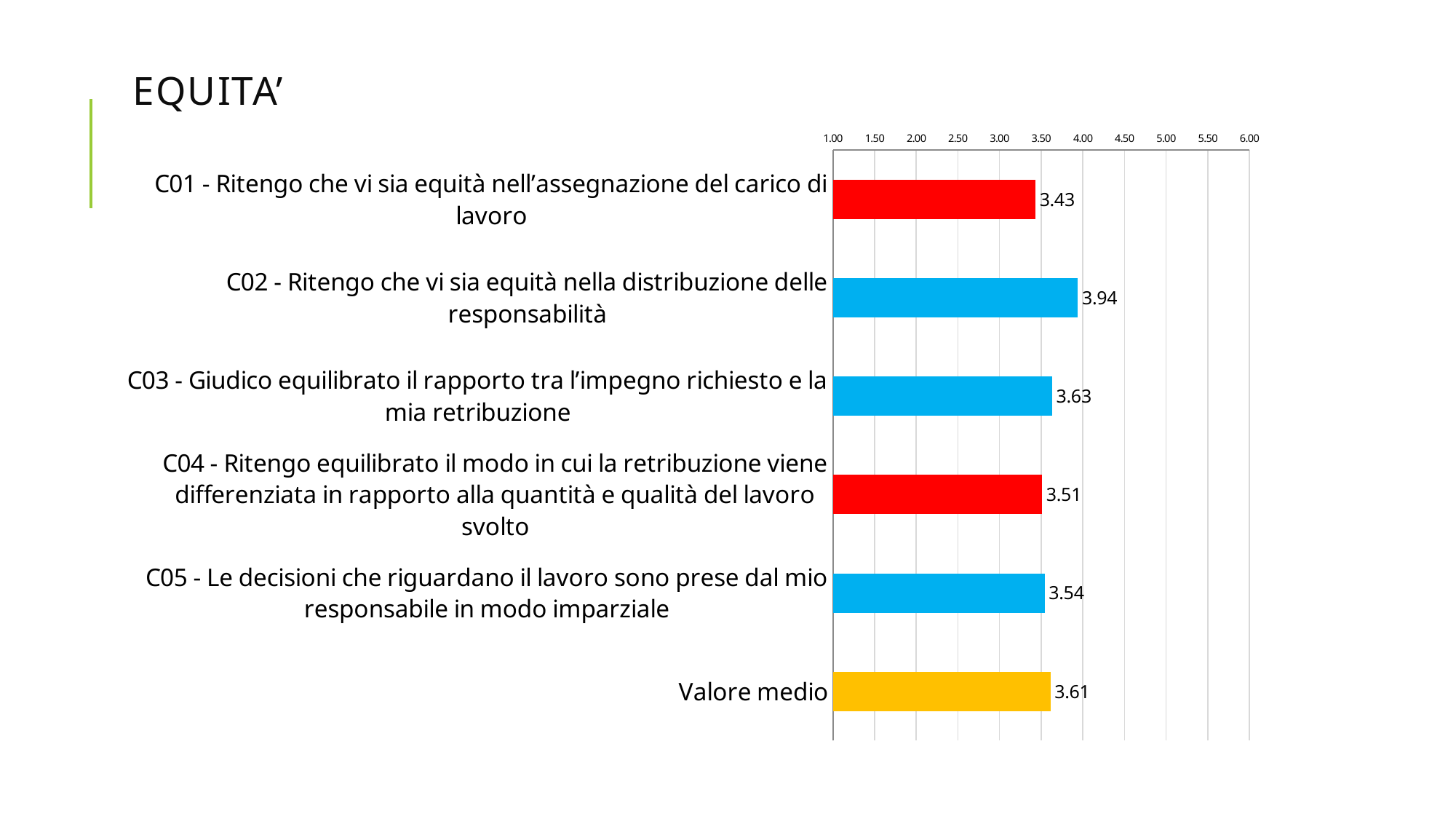
What kind of chart is shown on the slide? Bar chart What is the title of the slide? EQUITA' How many bars are shown in the chart? 6 Which item has the highest value? C02 - Ritengo che vi sia equità nella distribuzione delle responsabilità What is the value for C05 - Le decisioni che riguardano il lavoro sono prese dal mio responsabile in modo imparziale? 3.54 What is the difference between the values for C02 and C01? 0.51 What is the value for C02 - Ritengo che vi sia equità nella distribuzione delle responsabilità? 3.94 What is the value for C01 - Ritengo che vi sia equità nell'assegnazione del carico di lavoro? 3.43 What is the value shown for Valore medio? 3.61 Which item has the lowest value? C01 - Ritengo che vi sia equità nell'assegnazione del carico di lavoro Which has a larger value, C03 or C04? C03 Is the value for C02 greater or less than 3.50? greater